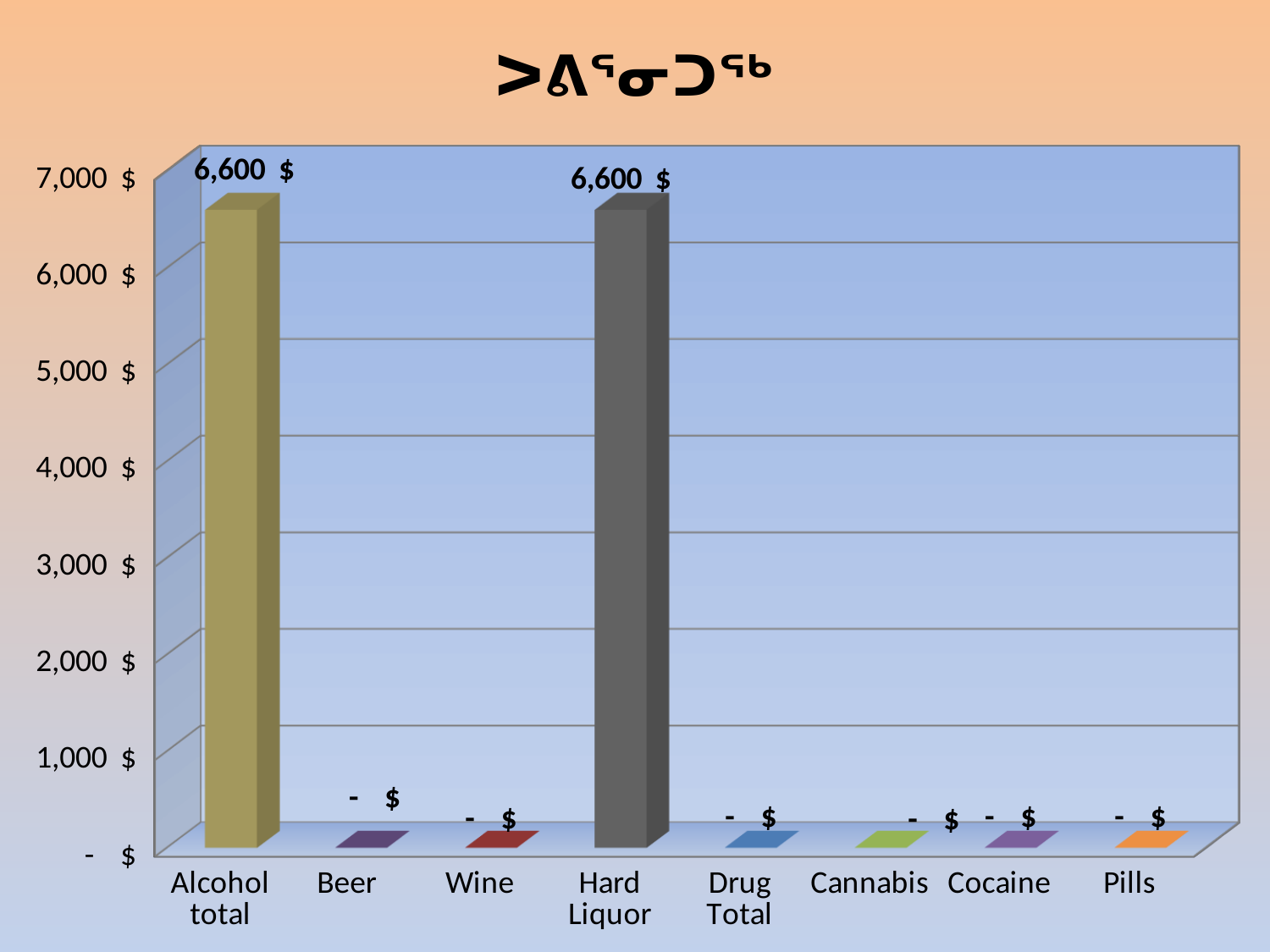
Is the value for Hard Liquor greater or less than 6,000 $? greater How many categories have a data label of "- $"? 6 Which is larger, the value for Hard Liquor or the value for Cannabis? Hard Liquor What is the data label shown for Pills? - $ What is the value for Hard Liquor? 6,600 $ What is the difference between the value for Alcohol total and the value for Hard Liquor? 0 $ What kind of chart is shown on the slide? bar chart What is the value for Alcohol total? 6,600 $ How many categories are shown on the x axis? 8 Which is larger, the value for Alcohol total or the value for Wine? Alcohol total What is the data label shown for Beer? - $ What is the data label shown for Drug Total? - $